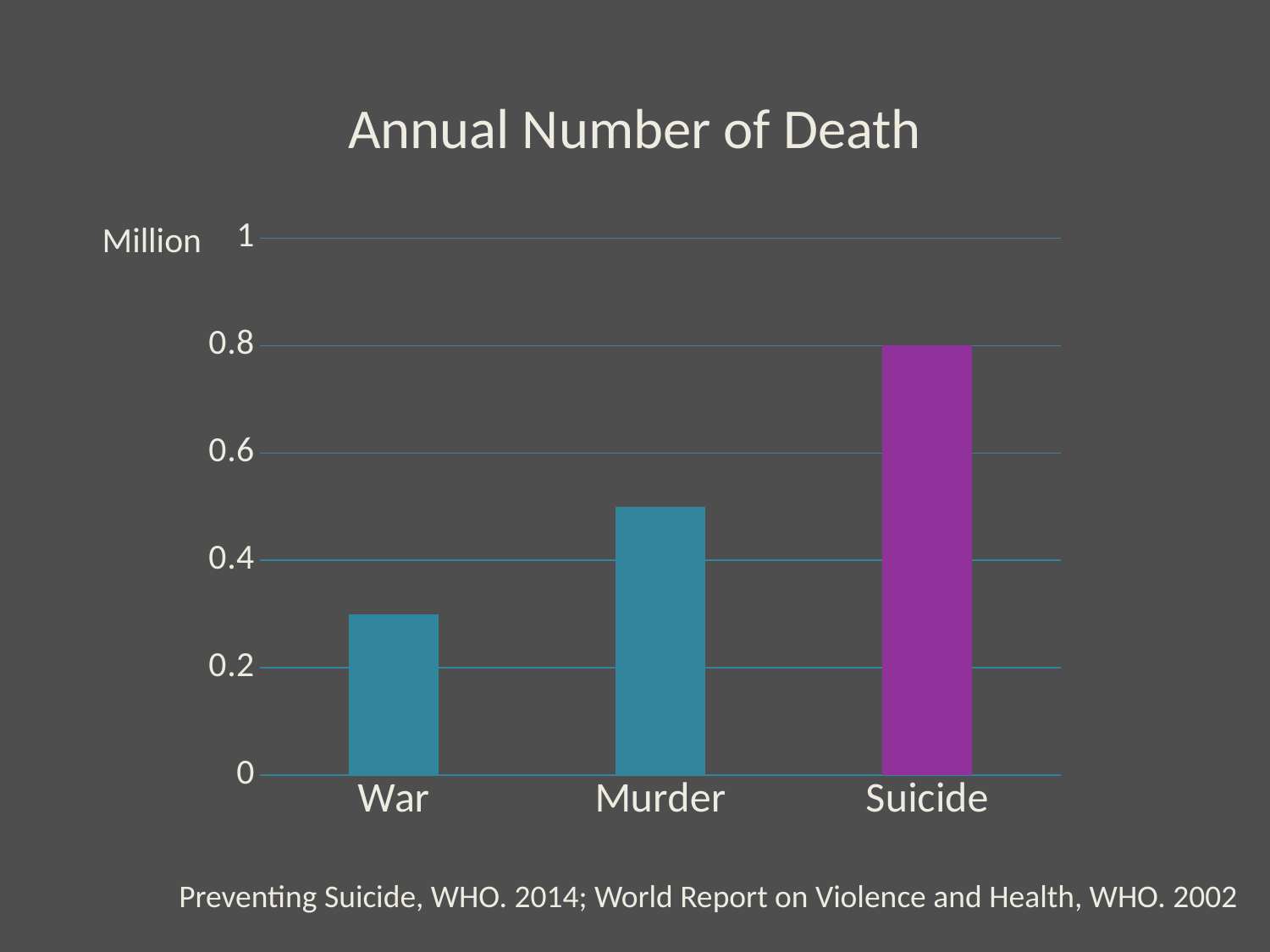
Which category has the lowest annual number of deaths? War Which is larger, the value for Murder or the value for War? Murder Is the value for War greater or less than 0.2? greater Is the value for War greater or less than 0.4? less What unit is indicated for the vertical axis of the chart? Million Is the value for Murder greater or less than 0.4? greater What is the title of the chart? Annual Number of Death Which category has the highest annual number of deaths? Suicide What kind of chart is shown on the slide? bar chart How many categories are shown on the x axis of the chart? 3 What is the value for Suicide, in millions? 0.8